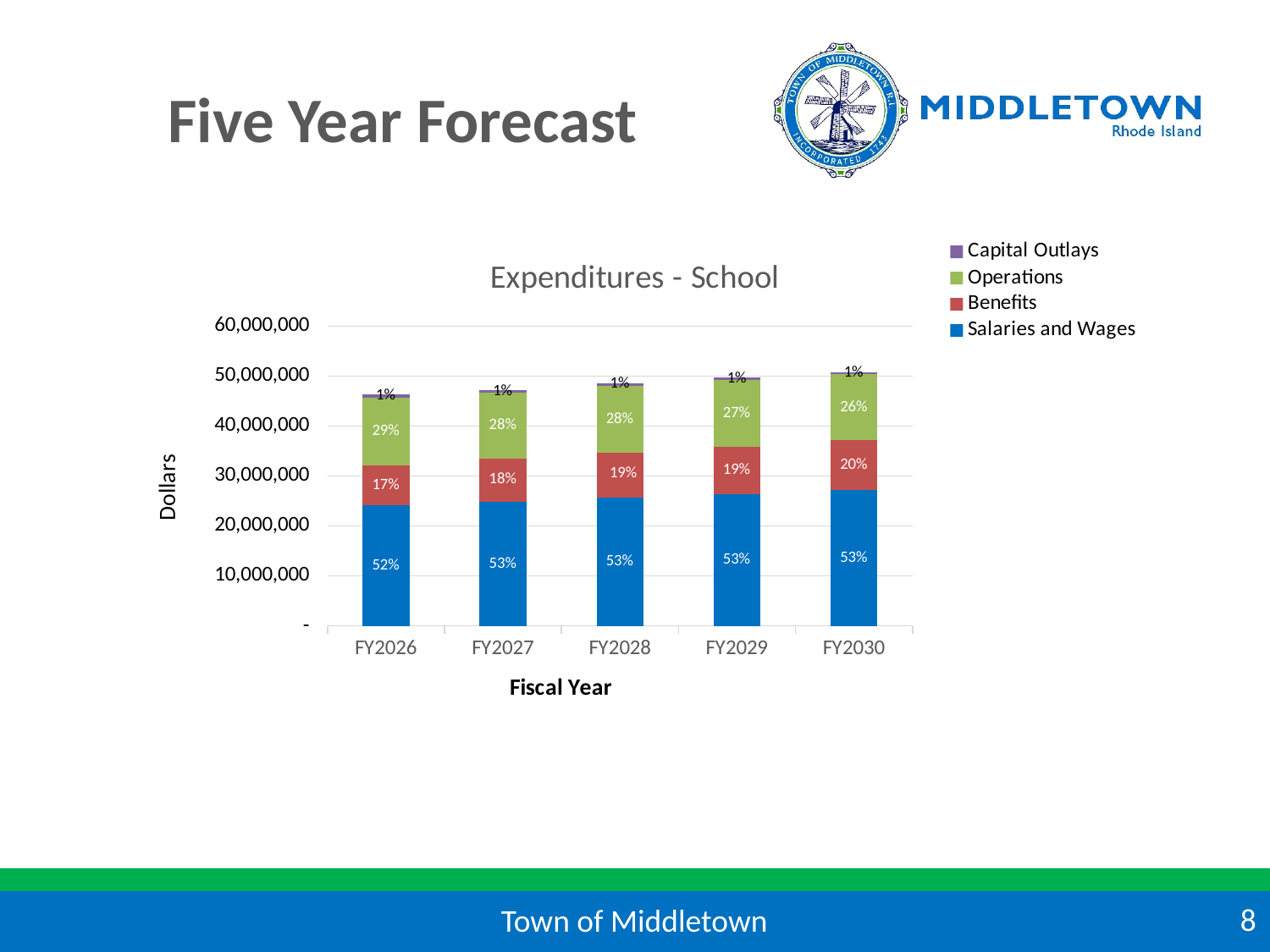
What kind of chart is shown on the slide? Stacked bar chart How many fiscal years are shown on the x axis? 5 Is the total school expenditure for FY2026 greater or less than 50,000,000? less Which is larger, the Benefits share in FY2026 or in FY2030? FY2030 How many series does the legend list? 4 What percentage of FY2030 school expenditures is Operations? 26% What is the title of the chart? Expenditures - School What percentage of FY2028 school expenditures is Benefits? 19% What percentage of FY2029 school expenditures is Capital Outlays? 1% Does the Operations share rise or fall from FY2026 to FY2030? Fall Which fiscal year has the tallest total expenditure bar? FY2030 What percentage of FY2026 school expenditures is Salaries and Wages? 52%